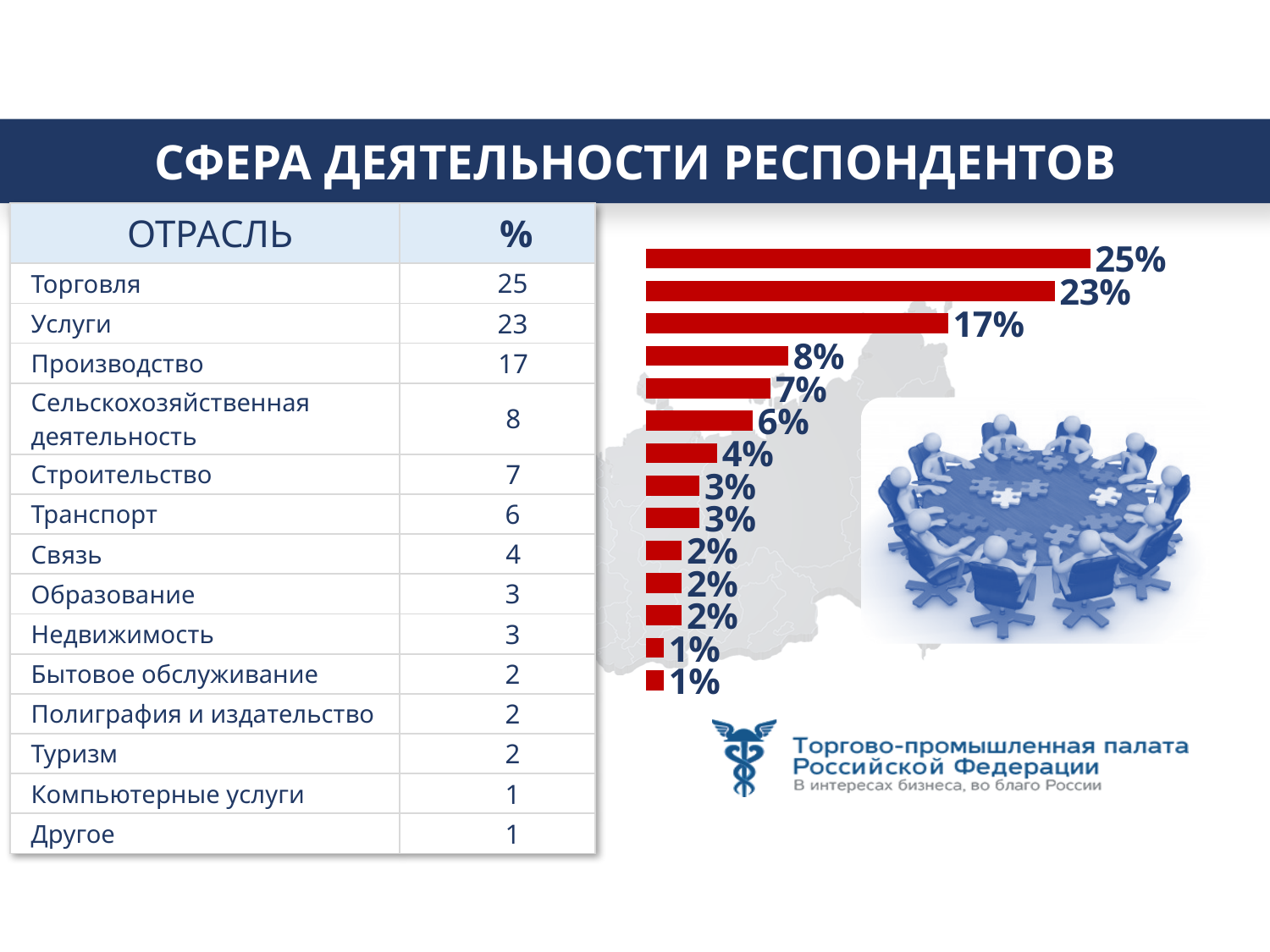
What is the difference between the third bar (17%) and the fourth bar (8%) in the chart? 9% What is the value of the fourth bar from the top of the chart? 8% What is the value of the second bar from the top of the chart? 23% How many bars does the chart contain? 14 What colour are the bars in the chart? red Do the bar values rise or fall going from the top of the chart to the bottom? fall What is the value shown on the shortest bars at the bottom of the chart? 1% What is the value of the third bar from the top of the chart? 17% What kind of chart is shown on the slide? bar chart Which is larger in the chart: the bar labelled 7% or the bar labelled 6%? 7% What is the value shown on the longest (top) bar of the chart? 25% What is the difference between the top bar (25%) and the second bar (23%) in the chart? 2%